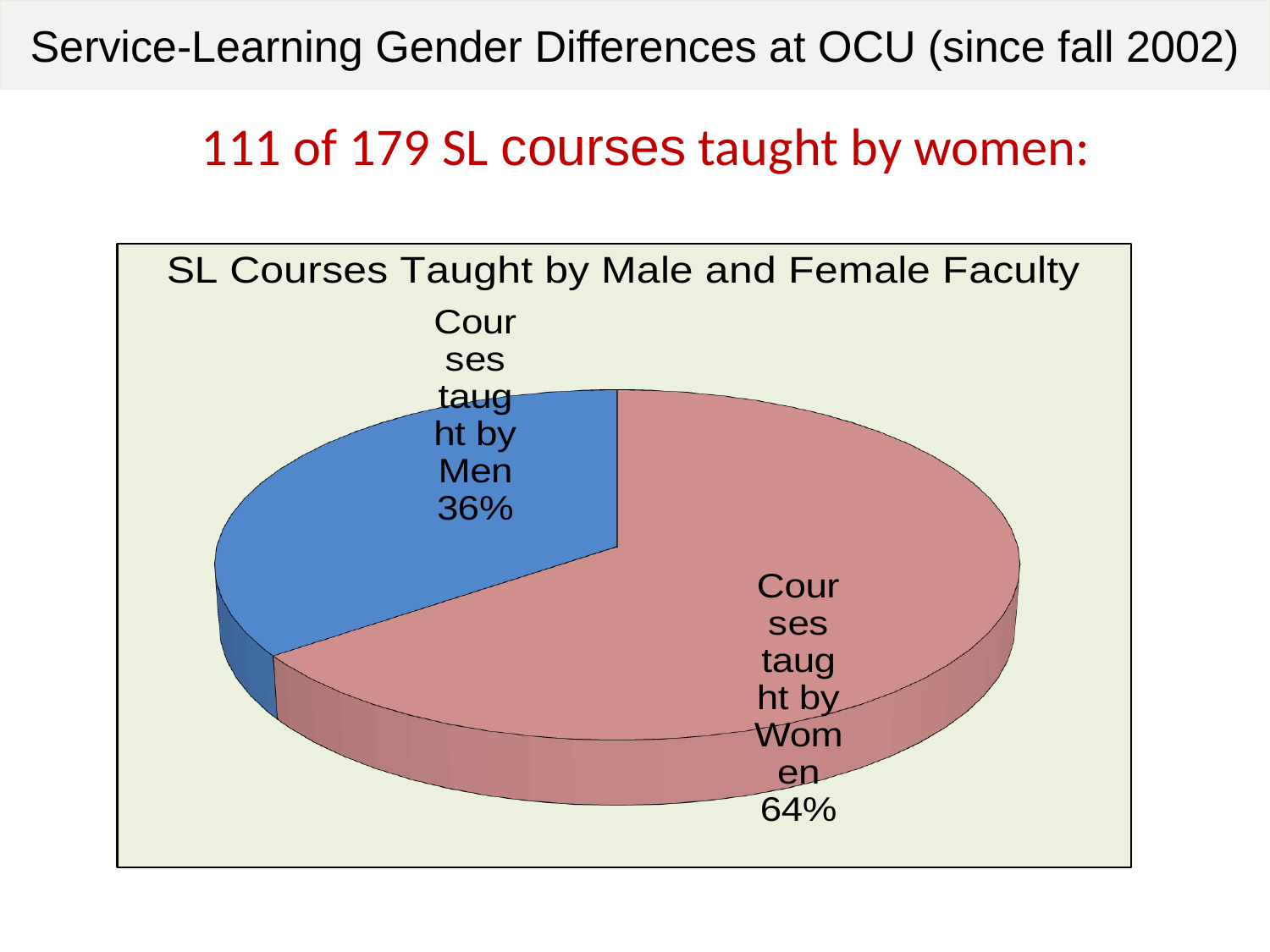
Is the share of courses taught by Men greater or less than 50%? less What is the difference in percentage points between the share of courses taught by Women and the share taught by Men? 28% What is the chart's title? SL Courses Taught by Male and Female Faculty What kind of chart is shown on the slide? pie chart What colour is the slice for courses taught by Men? blue Which category has the smallest share of the pie? Courses taught by Men Which slice is larger: courses taught by Men or courses taught by Women? Courses taught by Women What share of SL courses were taught by women? 64% What share of SL courses were taught by men? 36% Which category has the largest share of the pie? Courses taught by Women How many slices does the pie chart have? 2